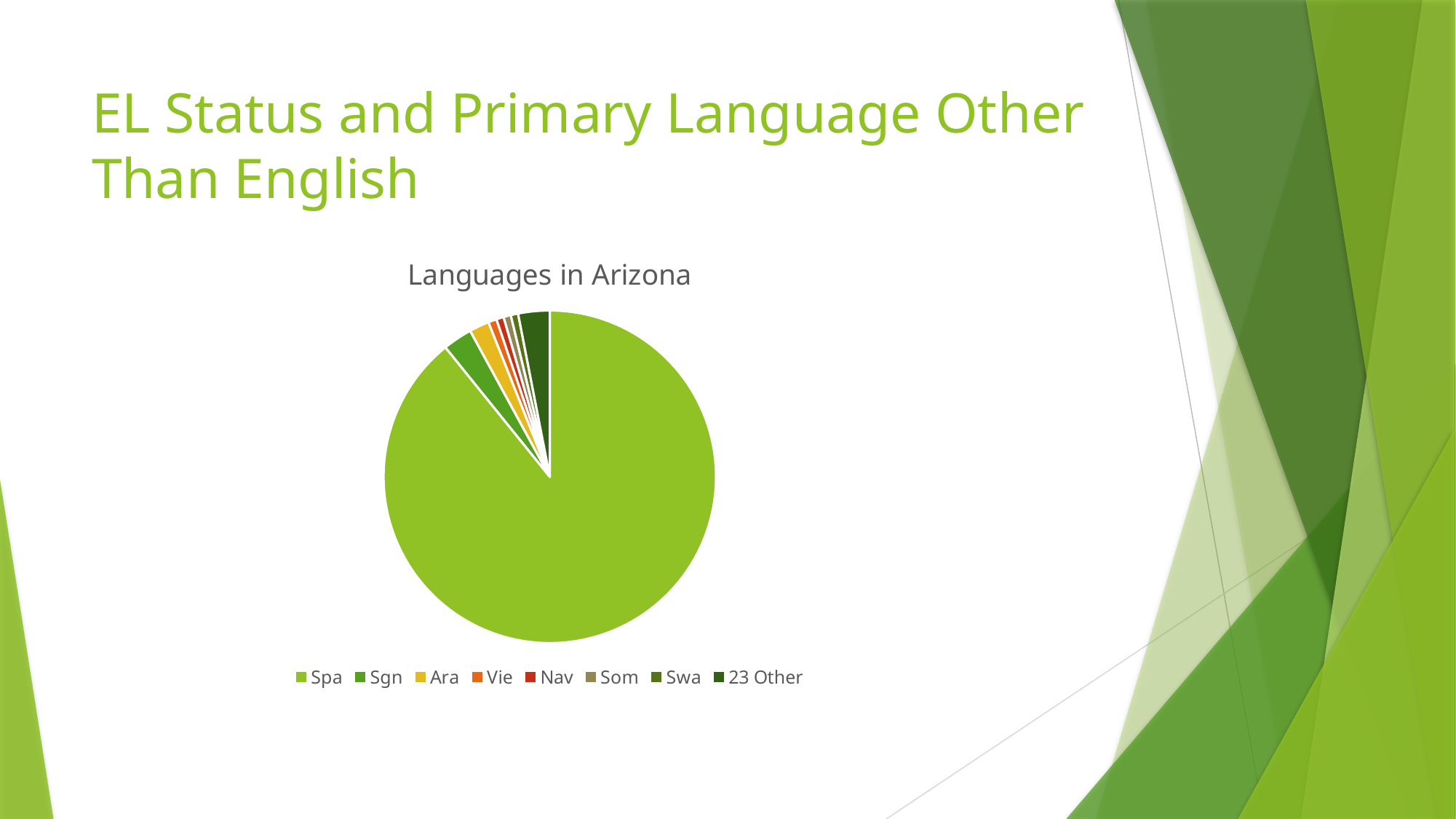
Which is larger, the slice for Sgn or the slice for Ara? Sgn What are the legend entries of the chart, in order? Spa, Sgn, Ara, Vie, Nav, Som, Swa, 23 Other Which is larger, the slice for Spa or the slice for 23 Other? Spa Which category has the largest slice of the pie? Spa Which is larger, the slice for 23 Other or the slice for Vie? 23 Other How many categories does the pie chart have? 8 What kind of chart is shown on the slide? pie chart What is the title of the chart? Languages in Arizona